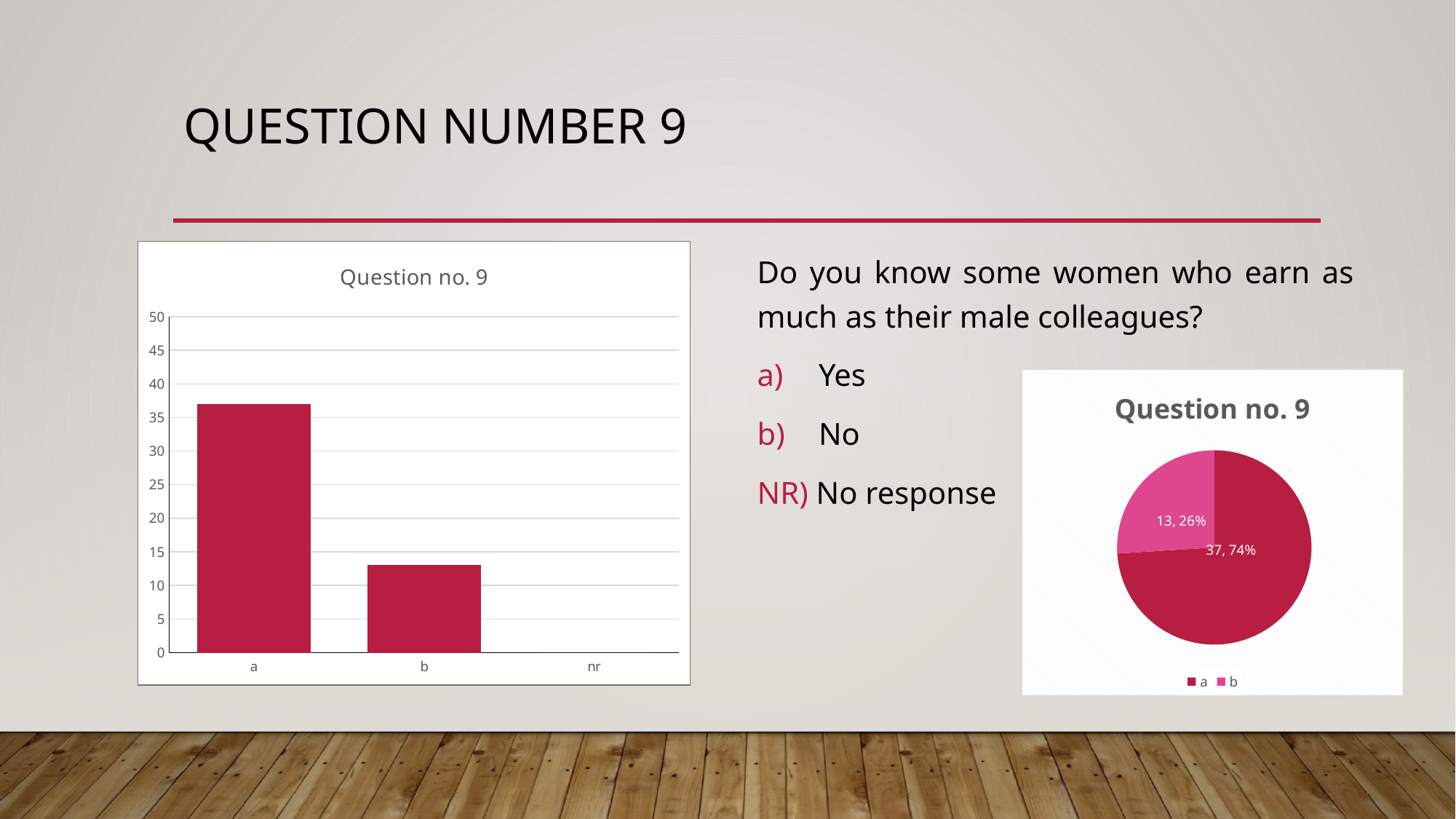
In the bar chart on the left, how many categories are shown on the x axis? 3 In the pie chart on the right, what share of the pie does slice b have? 26% In the bar chart on the left, is the value for b greater or less than 15? less In the bar chart on the left, which category has the highest bar? a What kind of chart is the chart on the left of the slide? bar chart In the bar chart on the left, is the value for a greater or less than 35? greater In the pie chart on the right, what is the difference between the values for a and b? 24 How many entries does the legend of the pie chart on the right list? 2 What kind of chart is the chart on the right of the slide? pie chart In the bar chart on the left, which category has the lowest value? nr In the pie chart on the right, what is the value shown for slice a? 37 In the bar chart on the left, which is larger, the value for a or the value for b? a